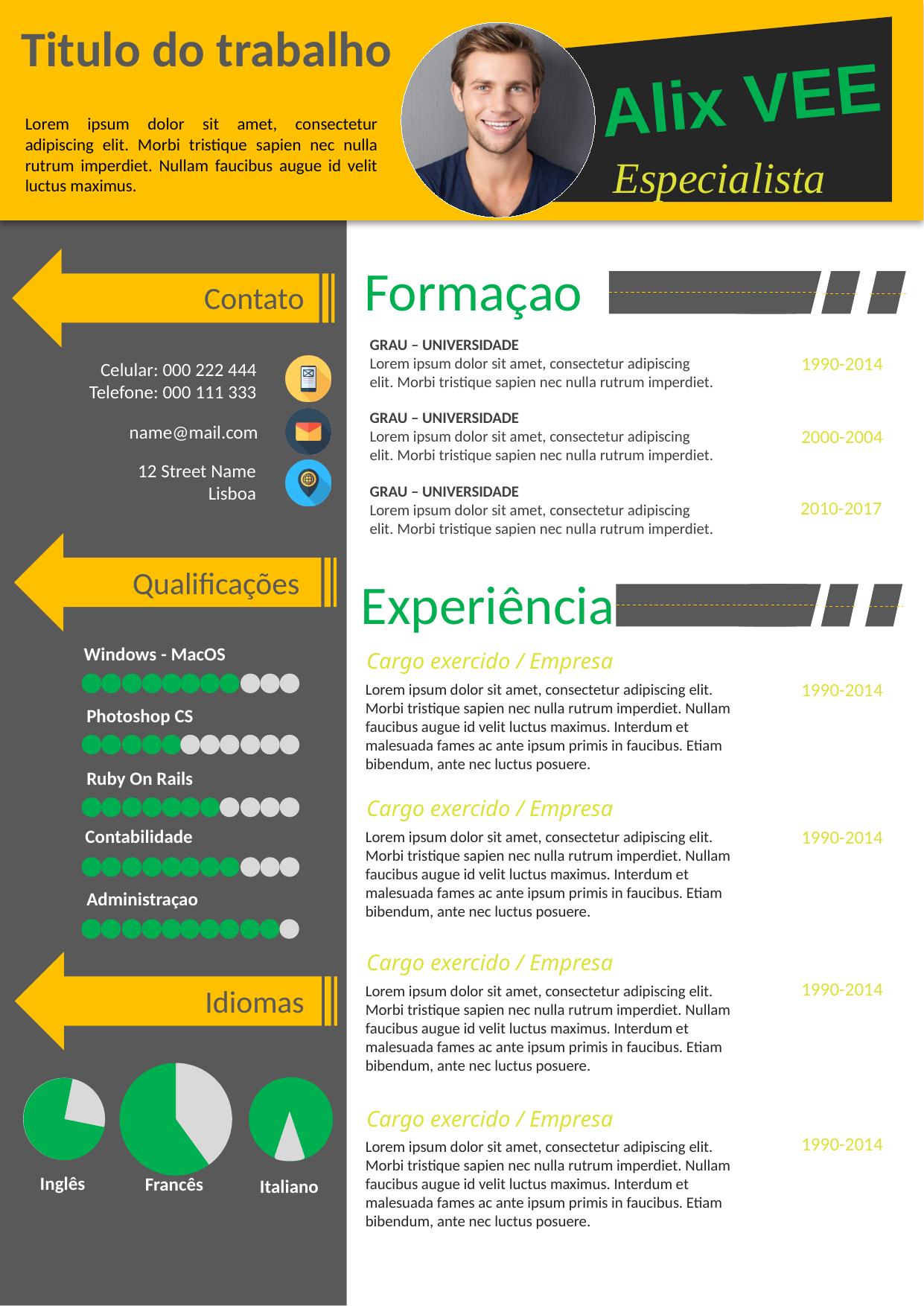
In the Qualificações section, which skill has the fewest green dots? Photoshop CS In the Qualificações section, how many dots are in each skill rating row? 12 What kind of charts are shown in the Idiomas section? Pie charts What colour is the filled (larger) portion of the Idiomas pie charts? Green In the Idiomas pie charts, which has the larger green share, Italiano or Inglês? Italiano In the Qualificações section, how many green dots does Ruby On Rails have? 8 What are the labels of the three pie charts in the Idiomas section, from left to right? Inglês, Francês, Italiano In the Idiomas pie charts, which has the larger green share, Inglês or Francês? Inglês How many pie charts are shown in the Idiomas section? 3 In the Idiomas pie charts, which language has the largest green share? Italiano In the Qualificações section, which skill has the most green dots? Administraçao In the Idiomas pie charts, which language has the smallest green share? Francês